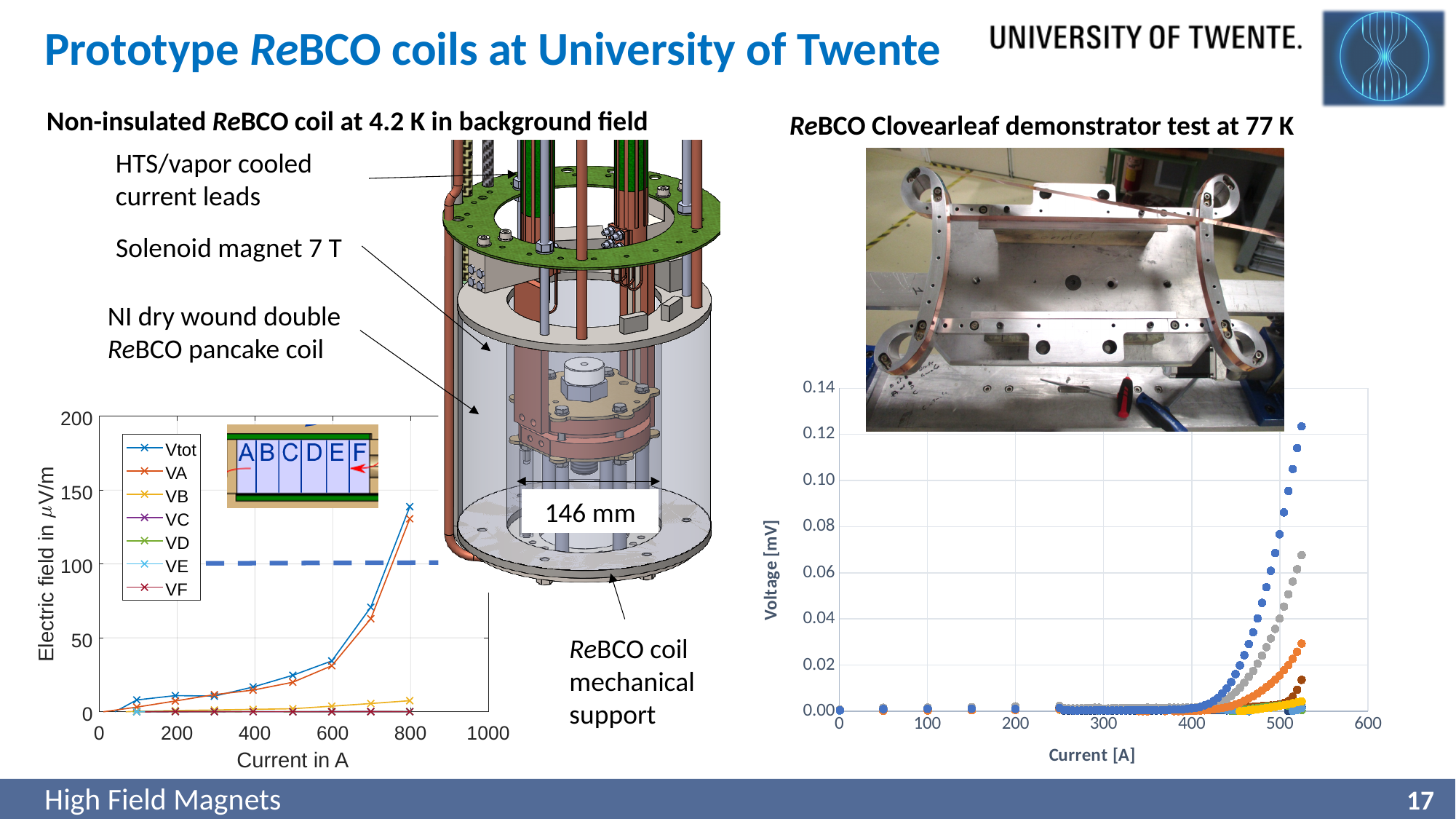
In the left chart (Electric field vs Current), is the VA value at 800 A greater or less than 100? greater In the left chart (Electric field vs Current), is the Vtot value at 800 A greater or less than 100? greater In the left chart (Electric field vs Current), which series reaches the highest electric field at 800 A? Vtot In the left chart (Electric field vs Current), how many series does the legend list? 7 In the right chart (Voltage [mV] vs Current [A]), is the highest orange point greater or less than 0.04 mV? less In the left chart (Electric field vs Current), what is the label of the x axis? Current in A In the left chart (Electric field vs Current), does the Vtot series rise or fall as current increases? rise In the left chart (Electric field vs Current), at 800 A, which is larger: Vtot or VB? Vtot In the left chart (Electric field vs Current), what is the label of the y axis? Electric field in µV/m In the right chart (Voltage [mV] vs Current [A]), what is the label of the y axis? Voltage [mV]